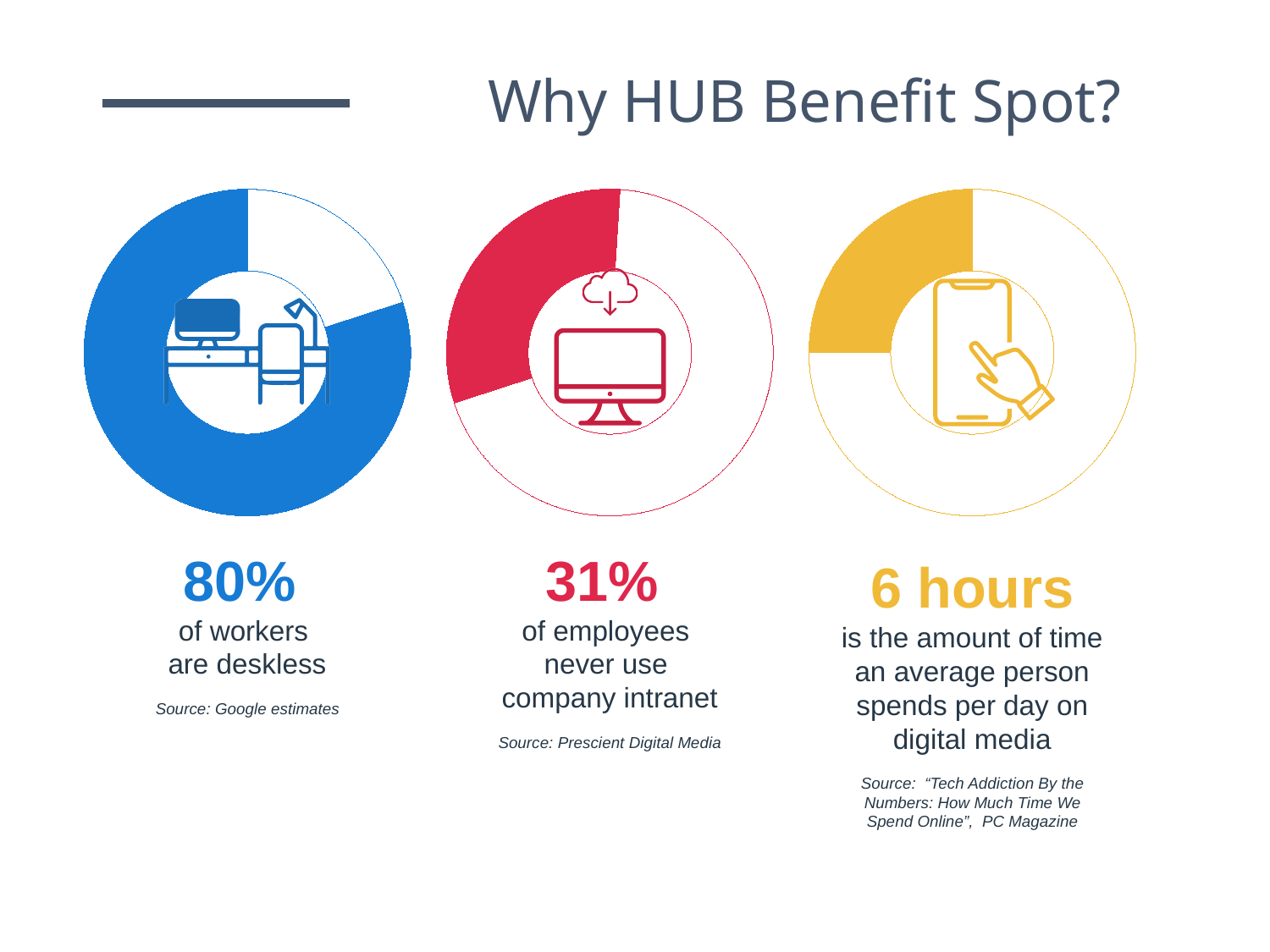
On the middle (red) donut chart, what percentage of employees never use the company intranet? 31% What is the difference in percentage points between the share of workers who are deskless (left chart) and the share of employees who never use the company intranet (middle chart)? 49 percentage points How many donut charts are shown on the slide? 3 What colour is the filled portion of the middle donut chart (31% of employees never use company intranet)? Red Which donut chart shows the larger percentage, the left one (workers who are deskless) or the middle one (employees who never use the company intranet)? The left one (80%) What kind of chart is used for each of the three statistics on the slide? Donut (pie) chart Of the two percentage donut charts on the slide, which statistic has the lowest value? 31% of employees never use company intranet On the left donut chart, what share of the ring is filled in blue? 80% On the left (blue) donut chart, what percentage of workers are deskless? 80% On the right (yellow) donut chart, how much time does an average person spend per day on digital media? 6 hours What is the title of the slide containing the three donut charts? Why HUB Benefit Spot?